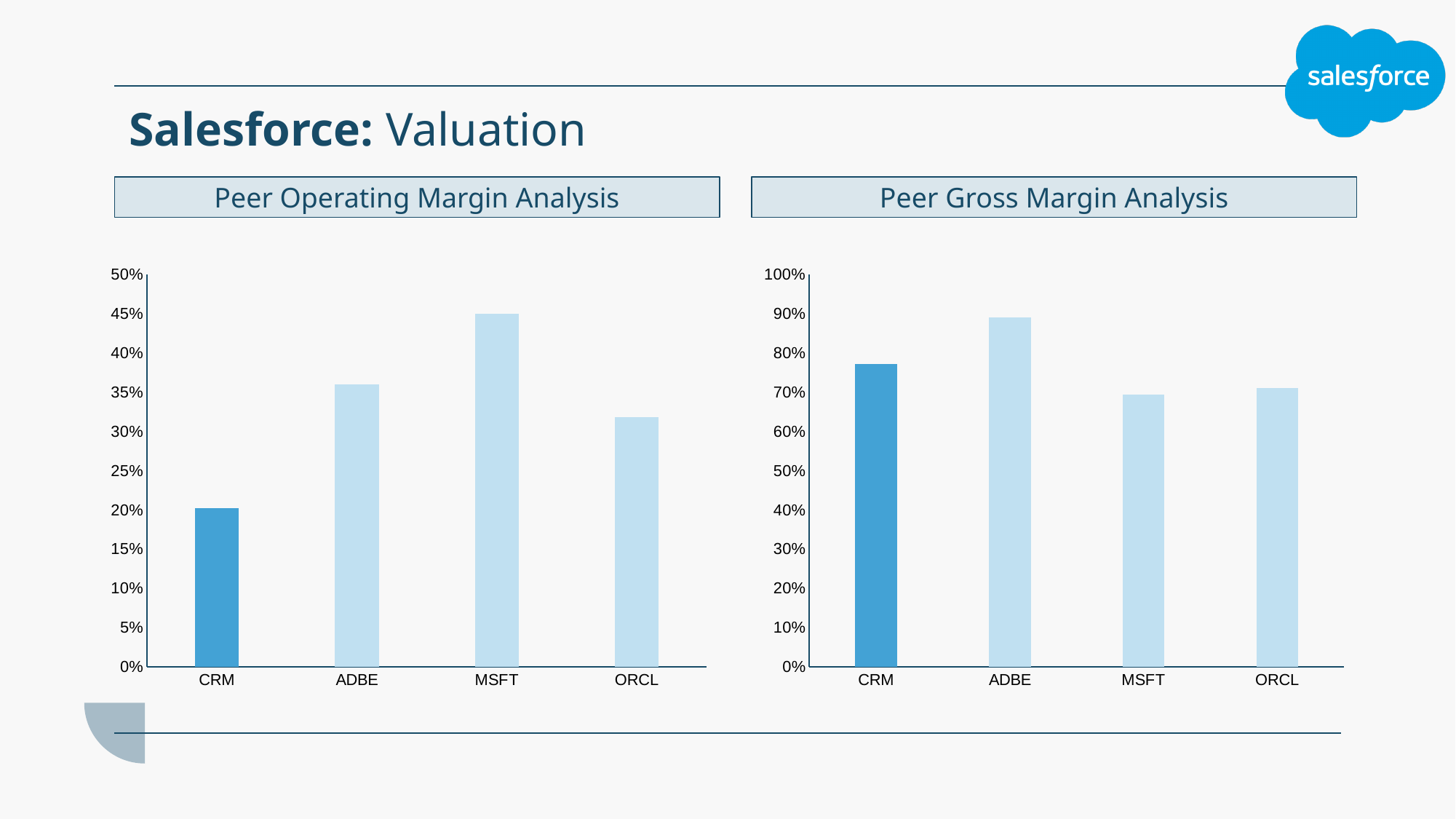
In the Peer Operating Margin Analysis chart, which company has the highest operating margin? MSFT In the Peer Operating Margin Analysis chart, is the value for ORCL greater or less than 35%? less In the Peer Operating Margin Analysis chart, is the value for CRM greater or less than 25%? less In the Peer Gross Margin Analysis chart, is the value for CRM greater or less than 70%? greater How many companies are shown in the Peer Gross Margin Analysis chart? 4 In the Peer Operating Margin Analysis chart, which is larger, the value for ADBE or the value for ORCL? ADBE What kind of chart is the Peer Operating Margin Analysis chart? Bar chart In the Peer Operating Margin Analysis chart, which company has the lowest operating margin? CRM In the Peer Gross Margin Analysis chart, which company has the highest gross margin? ADBE In the Peer Gross Margin Analysis chart, which is larger, the value for CRM or the value for ORCL? CRM